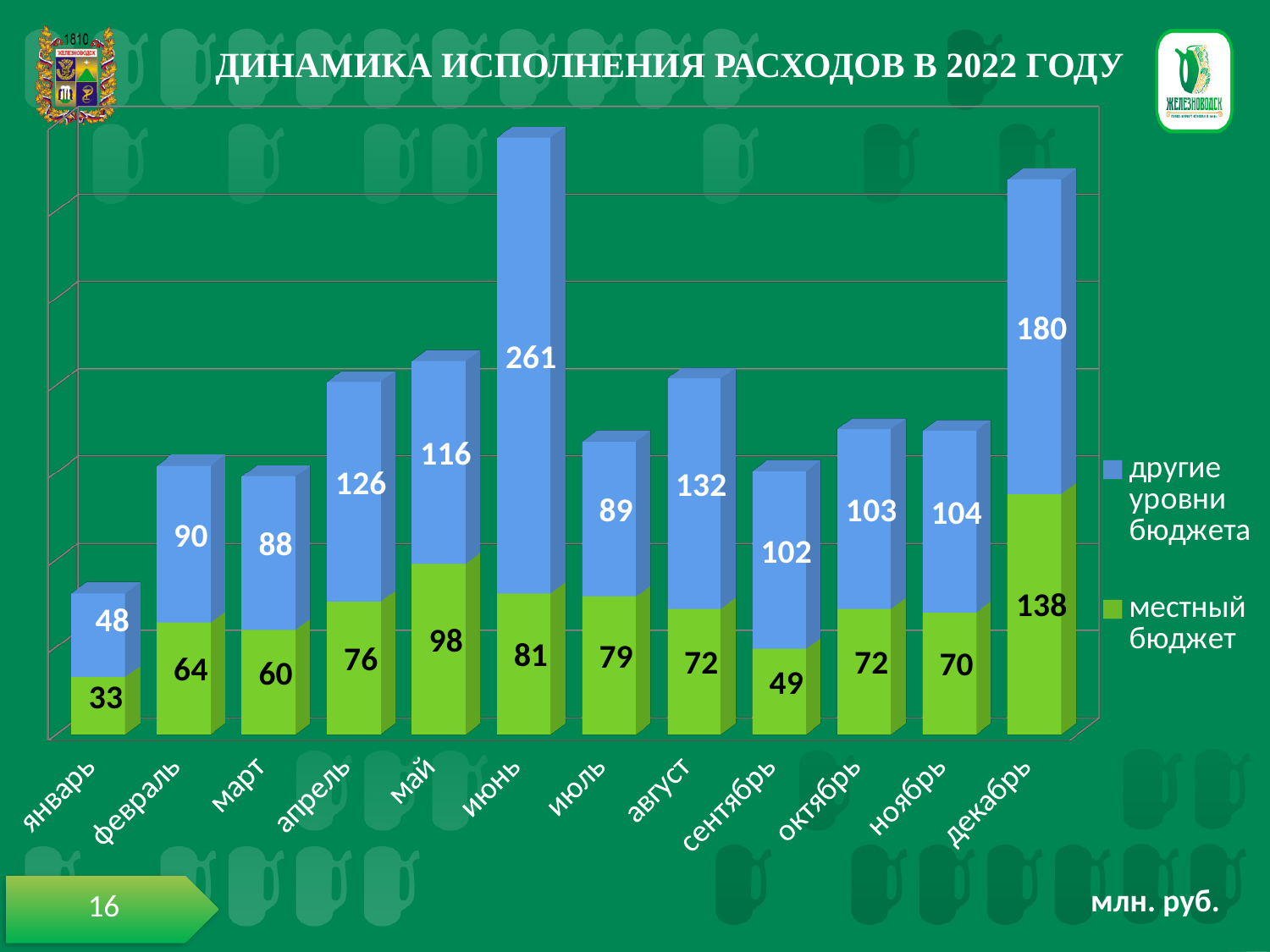
What kind of chart is shown on the slide? stacked bar chart Which is larger: the "местный бюджет" value for апрель or for июль? июль Which month has the lowest value for "местный бюджет"? январь How many months are shown on the x axis? 12 What is the total of the stacked bar for январь? 81 What unit is indicated in the bottom right corner of the slide? млн. руб. How many series does the legend list? 2 What is the value of "другие уровни бюджета" for сентябрь? 102 What is the value of "местный бюджет" for май? 98 What is the total of the stacked bar for декабрь? 318 Which month has the highest value for "другие уровни бюджета"? июнь What is the difference between the "другие уровни бюджета" values for июнь and декабрь? 81